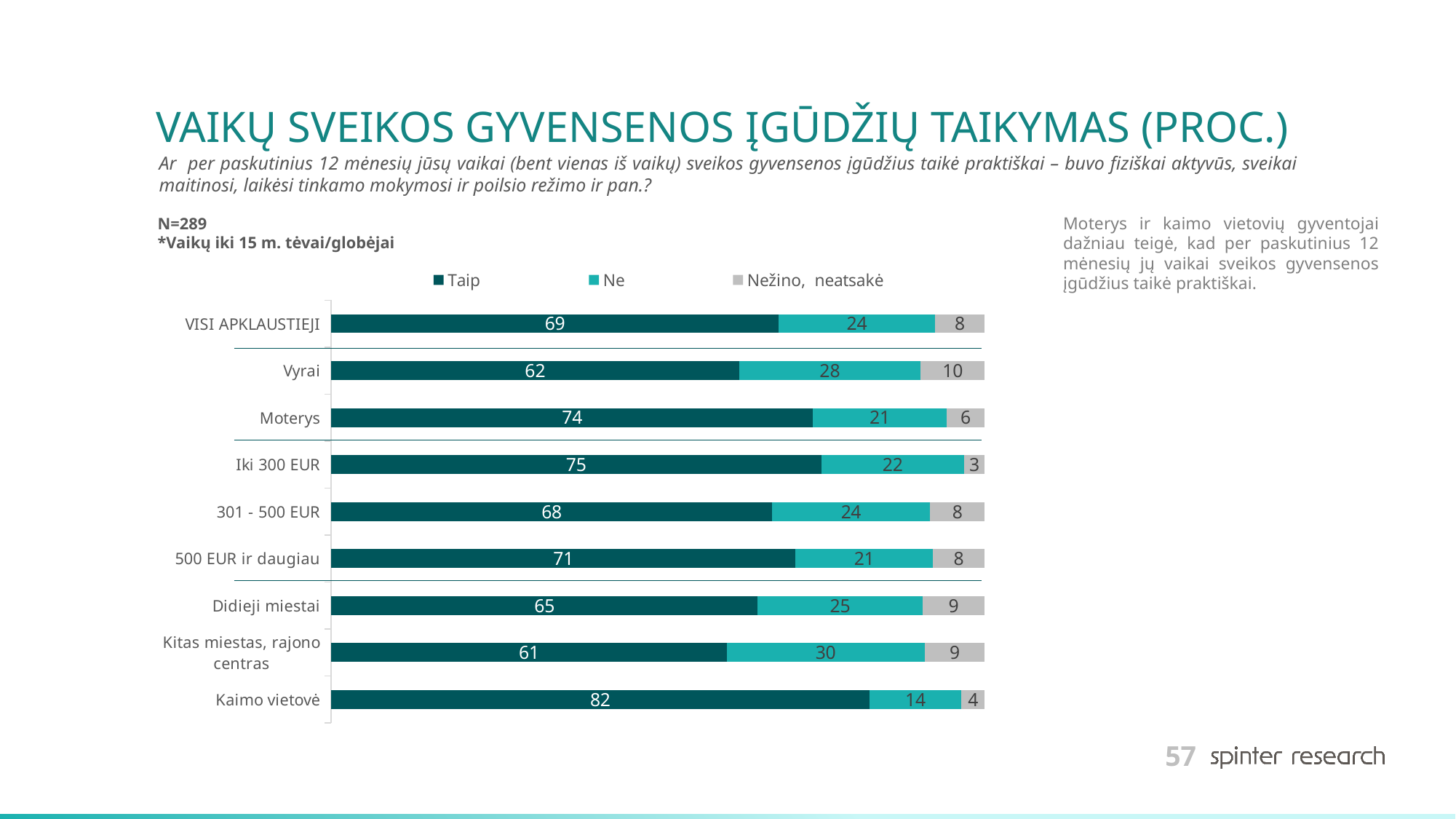
What is the total of the stacked bar for Kitas miestas, rajono centras? 100 Which category has the lowest "Taip" value? Kitas miestas, rajono centras How many series does the legend list? 3 What is the "Nežino, neatsakė" value for Iki 300 EUR? 3 What is the "Taip" value for Kaimo vietovė? 82 Which category has the highest "Taip" value? Kaimo vietovė What kind of chart is shown on the slide? Stacked bar chart How many categories are shown on the chart? 9 What is the "Ne" value for Vyrai? 28 Which has a larger "Taip" value, Didieji miestai or 500 EUR ir daugiau? 500 EUR ir daugiau Which category has the highest "Ne" value? Kitas miestas, rajono centras What is the difference between the "Taip" values for Moterys and Vyrai? 12